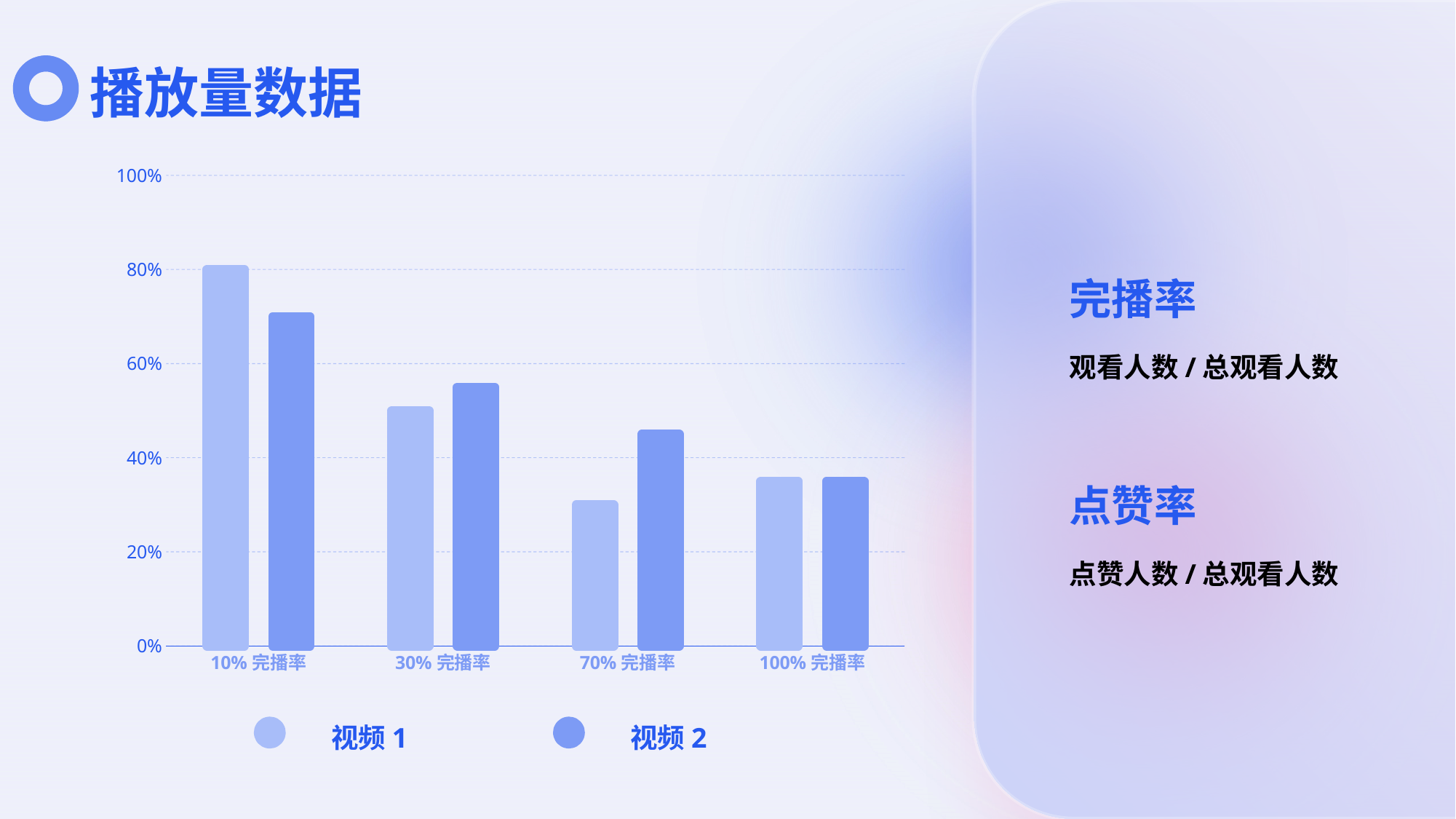
Do the values for 视频 2 rise or fall from 10% 完播率 to 100% 完播率? fall Which category has the lowest value for 视频 1? 70% 完播率 At 10% 完播率, which series has the larger value, 视频 1 or 视频 2? 视频 1 Which category has the highest value for 视频 1? 10% 完播率 What is the title of the chart on the slide? 播放量数据 What kind of chart is shown on the slide? bar chart How many series does the chart legend list? 2 Is the value for 视频 2 at 70% 完播率 greater or less than 40%? greater Which category has the lowest value for 视频 2? 100% 完播率 Is the value for 视频 1 at 10% 完播率 greater or less than 60%? greater How many categories are shown on the x axis of the chart? 4 Is the value for 视频 1 at 70% 完播率 greater or less than 40%? less